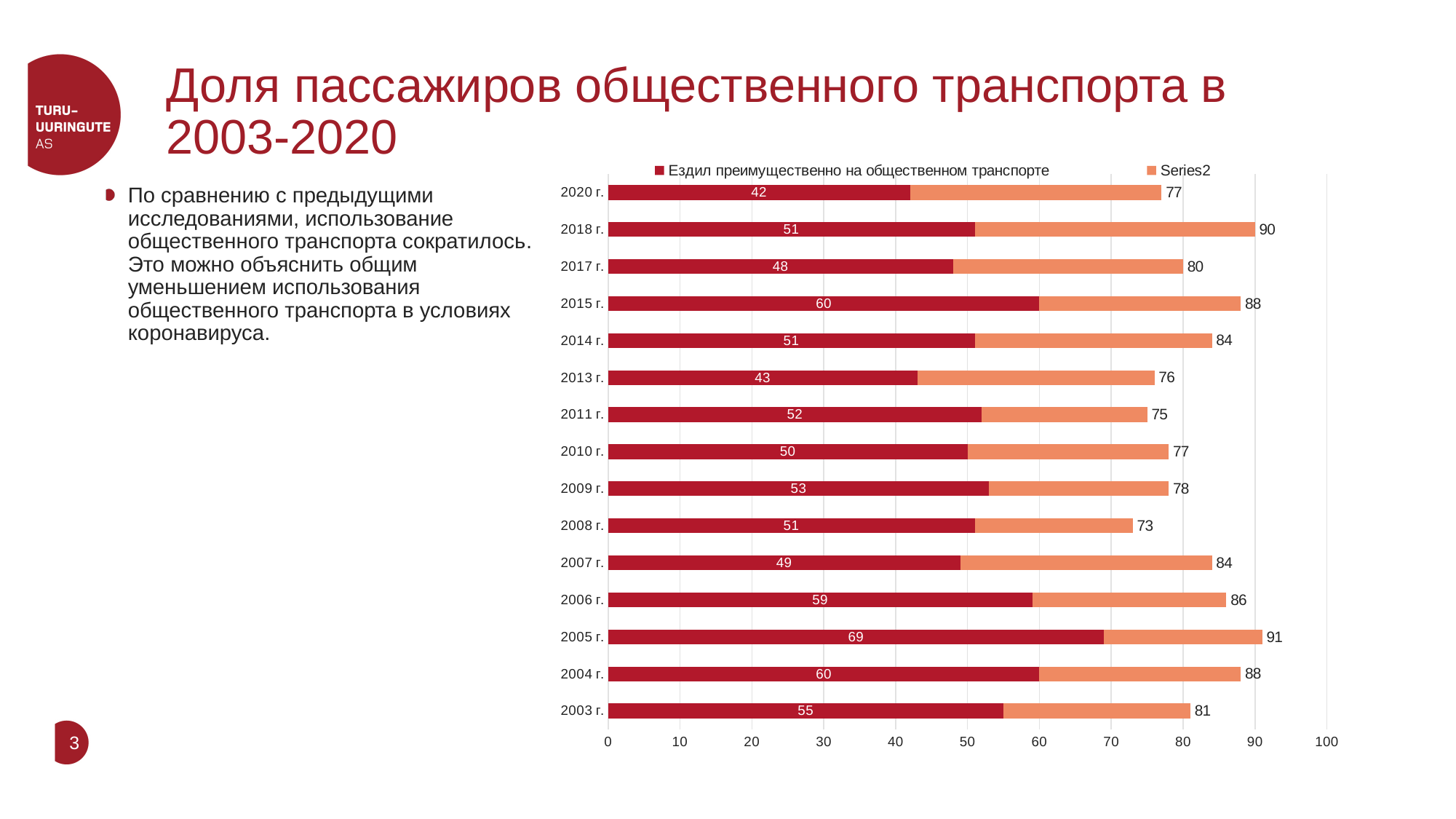
What is the difference between the 2005 г. and 2020 г. values in the series "Ездил преимущественно на общественном транспорте"? 27 Which year has the highest total at the end of its stacked bar? 2005 г. What is the legend label of the dark red series? Ездил преимущественно на общественном транспорте What kind of chart is shown on the slide? Stacked bar chart Which year has the highest value in the series "Ездил преимущественно на общественном транспорте"? 2005 г. How many series does the legend list? 2 What is the value for 2005 г. in the series "Ездил преимущественно на общественном транспорте"? 69 Which is larger in the series "Ездил преимущественно на общественном транспорте": 2015 г. or 2017 г.? 2015 г. What is the value for 2015 г. in the series "Ездил преимущественно на общественном транспорте"? 60 How many years (categories) are shown on the chart? 15 What is the total shown at the end of the stacked bar for 2018 г.? 90 Which year has the lowest value in the series "Ездил преимущественно на общественном транспорте"? 2020 г.